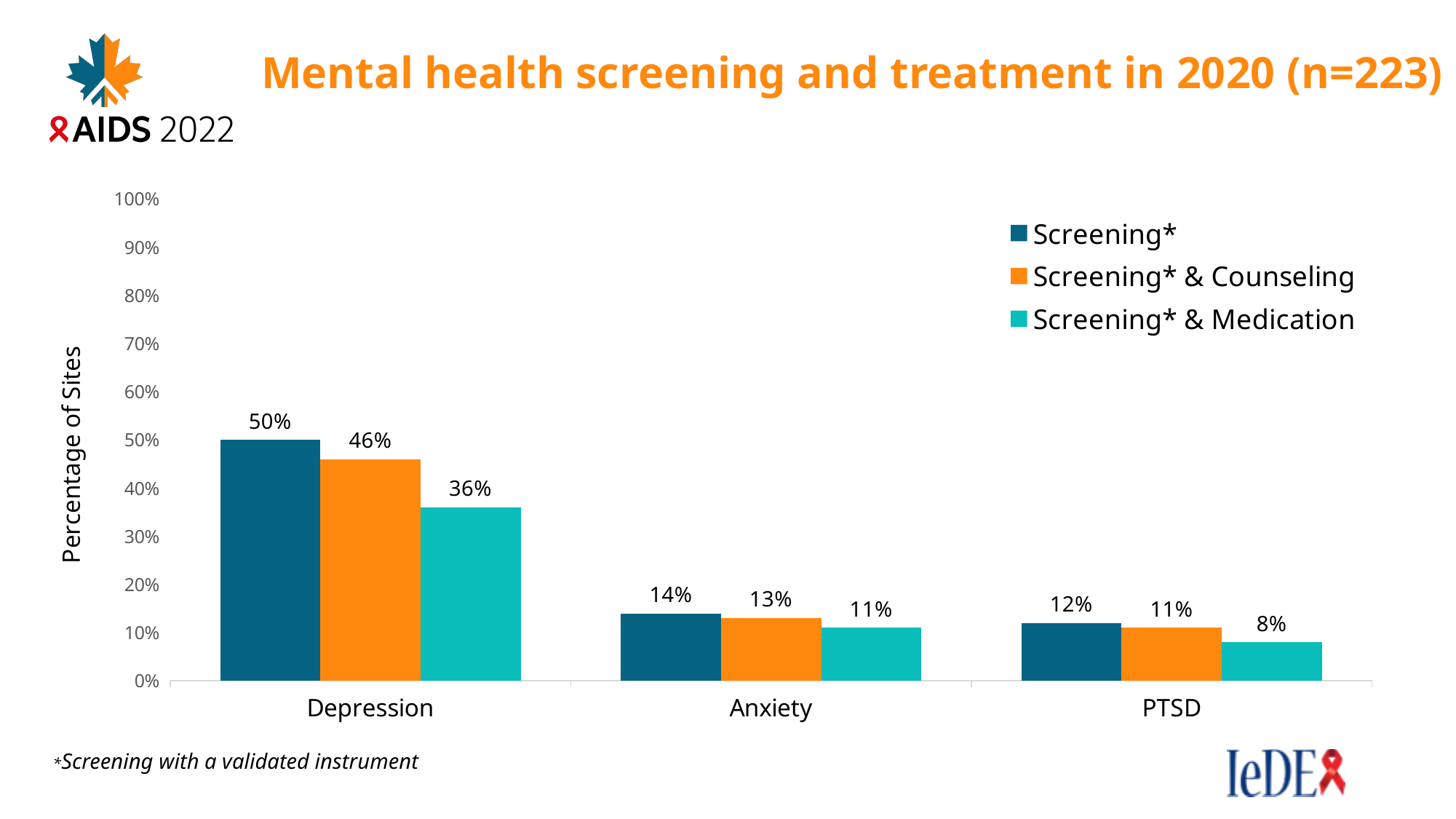
Do the Screening* values rise or fall from Depression to PTSD? Fall Which category has the lowest value for Screening* & Medication? PTSD Which category has the highest value for Screening*? Depression How many categories are shown on the x axis? 3 How many series does the legend list? 3 Which is larger: Screening* & Counseling for Anxiety or Screening* & Counseling for PTSD? Screening* & Counseling for Anxiety What kind of chart is shown on the slide? Bar chart What is the value for Screening* & Counseling for Anxiety? 13% What is the difference between the Screening* and Screening* & Medication values for Depression? 14% What is the value for Screening* & Medication for PTSD? 8% What percentage of sites is shown for Screening* for Depression? 50% What is the title of the chart? Mental health screening and treatment in 2020 (n=223)